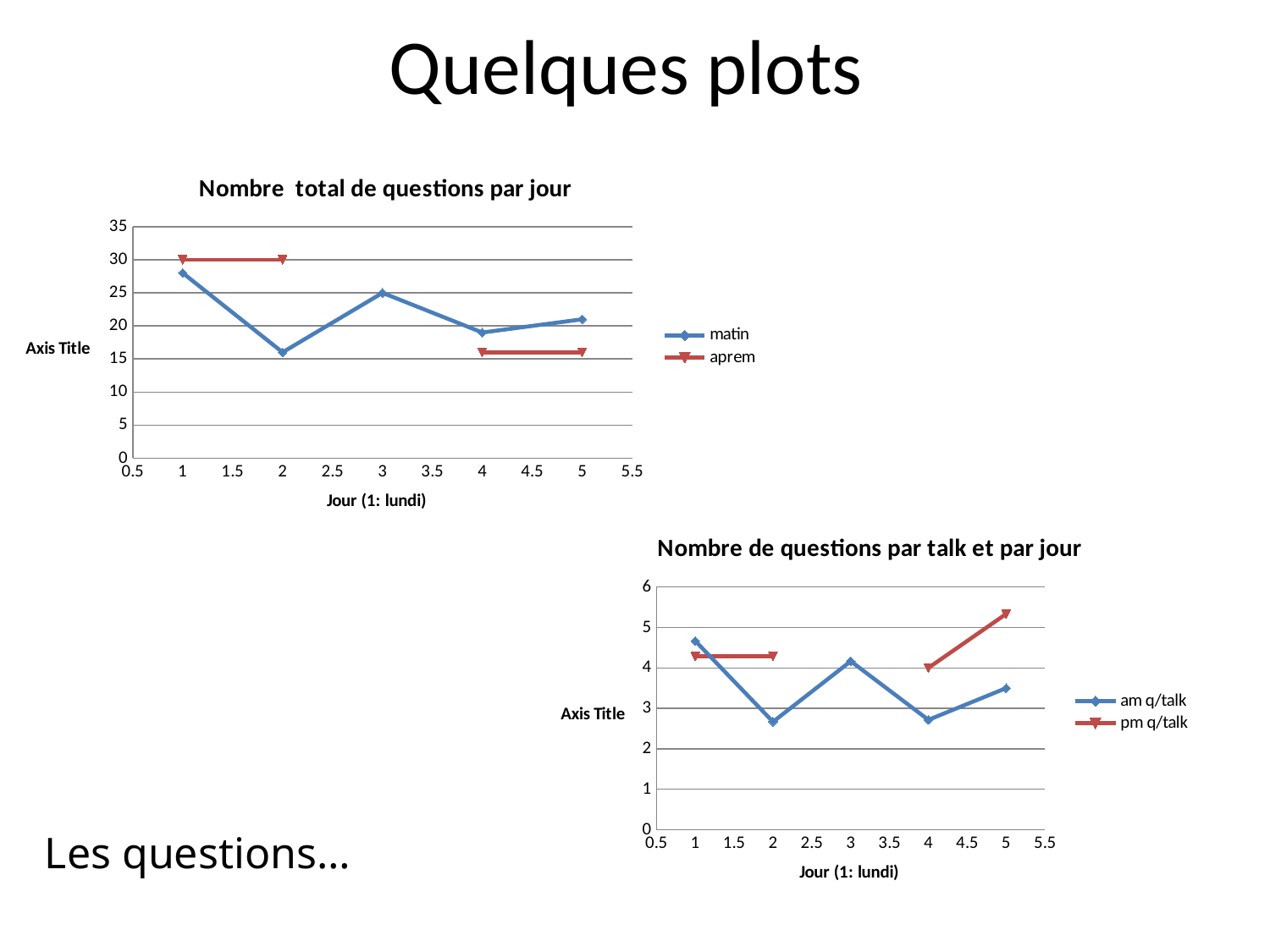
In "Nombre total de questions par jour", how many points does the matin series have? 5 In "Nombre total de questions par jour", is the matin value at day 1 greater or less than 25? greater In "Nombre total de questions par jour", which series is drawn in red? aprem In "Nombre total de questions par jour", is the matin value at day 2 greater or less than 20? less In "Nombre total de questions par jour", at which day is the matin series lowest? 2 In "Nombre total de questions par jour", at which day is the matin series highest? 1 In "Nombre total de questions par jour", which is larger at day 4: matin or aprem? matin What kind of chart is "Nombre total de questions par jour"? line chart What is the x-axis title of "Nombre de questions par talk et par jour"? Jour (1: lundi) In "Nombre de questions par talk et par jour", which is larger at day 2: am q/talk or pm q/talk? pm q/talk In "Nombre de questions par talk et par jour", is the pm q/talk value at day 5 greater or less than 5? greater How many series does the legend of "Nombre total de questions par jour" list? 2